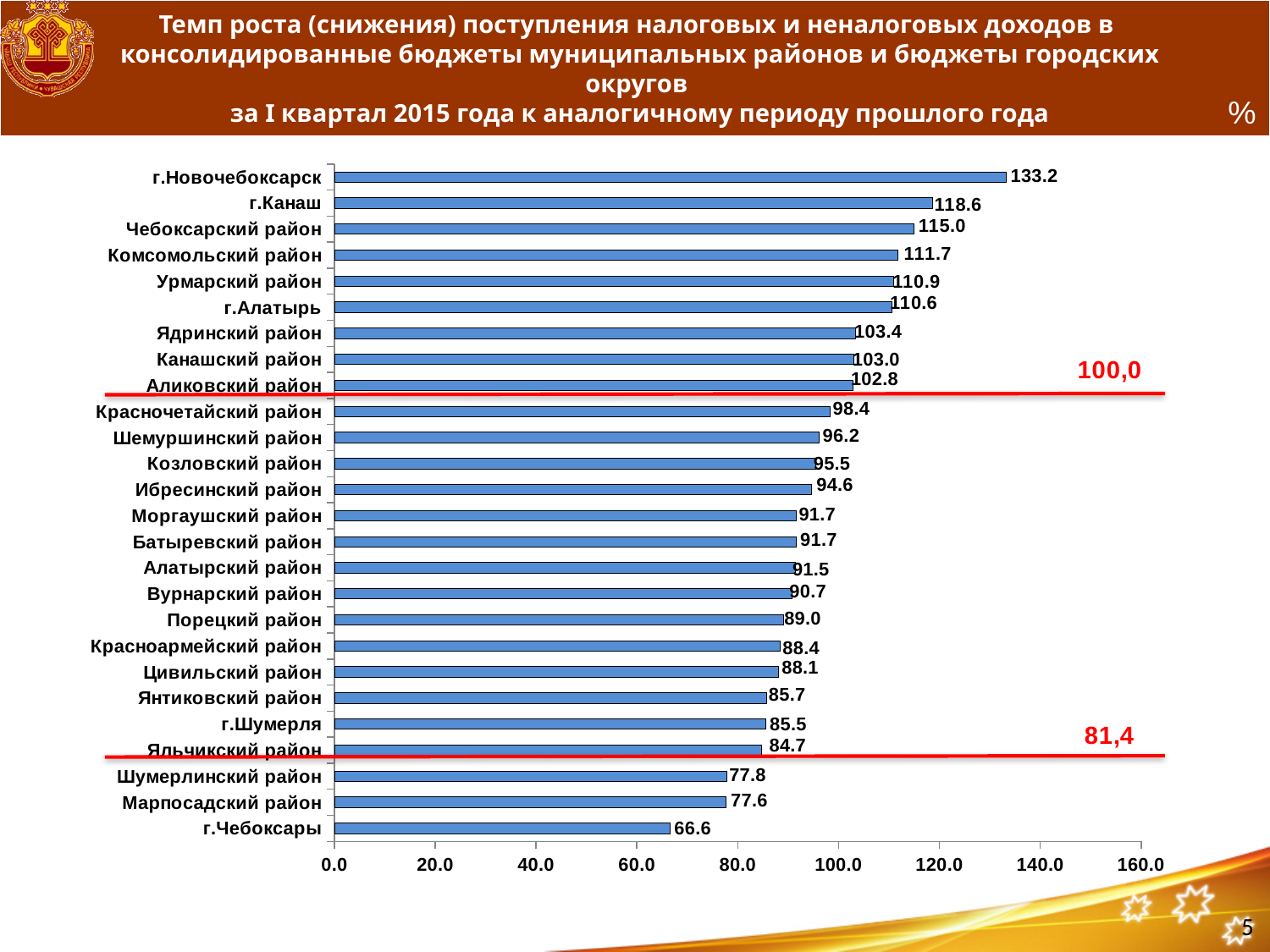
What kind of chart is shown on the slide? bar chart Which category has the highest value? г.Новочебоксарск How many categories are shown on the chart? 26 What is the difference between the values for г.Канаш and г.Чебоксары? 52.0 What value is marked by the upper red horizontal line on the chart? 100,0 What is the value for Марпосадский район? 77.6 Which category has the lowest value? г.Чебоксары What is the value for г.Новочебоксарск? 133.2 What is the value for Порецкий район? 89.0 What is the value for Комсомольский район? 111.7 Which is larger, the value for Ядринский район or the value for Красночетайский район? Ядринский район Is the value for Шумерлинский район greater or less than 80.0? less